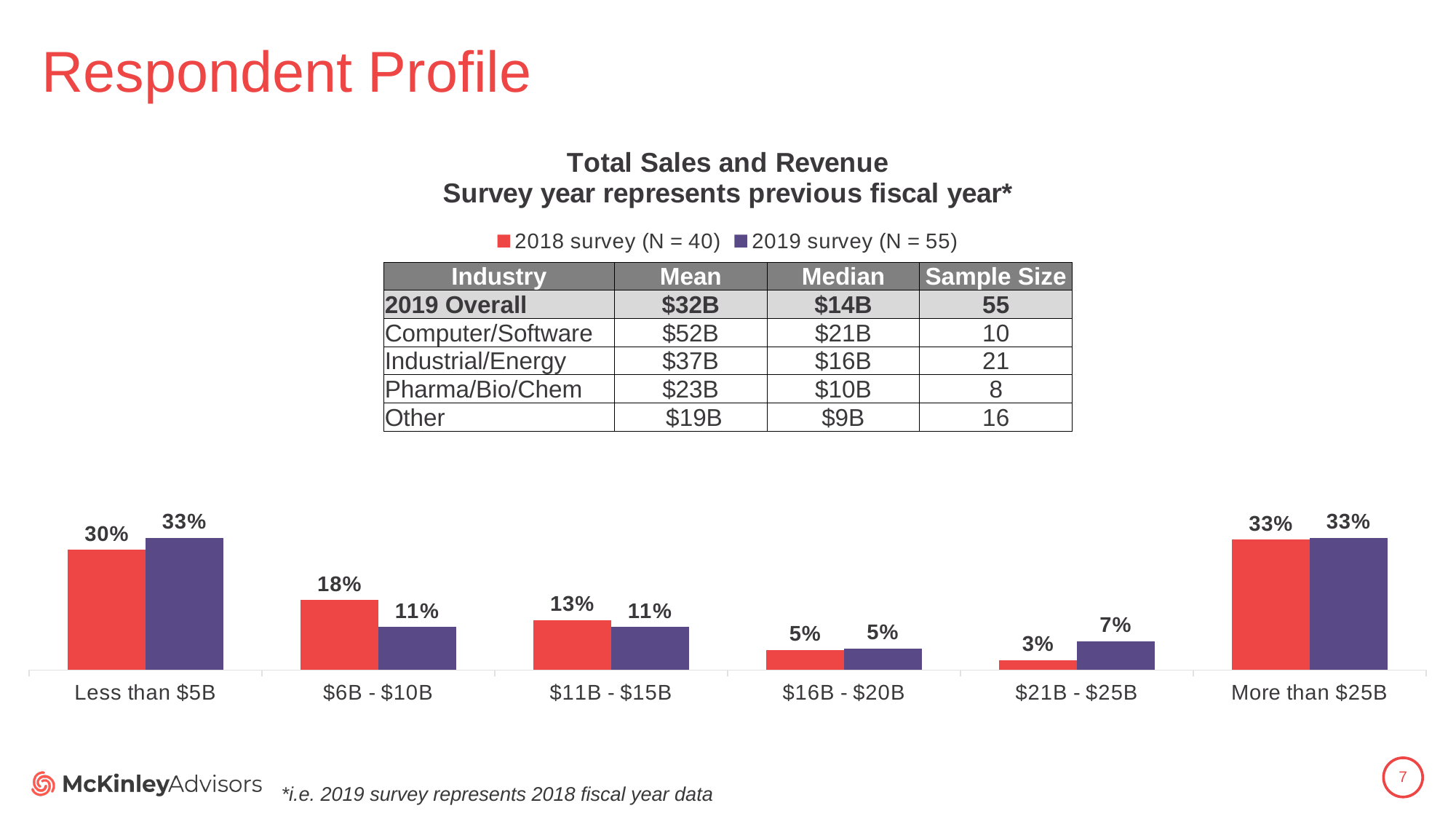
Which category has the lowest value for the 2018 survey? $21B - $25B What is the difference between the 2018 survey and 2019 survey values in the $6B - $10B category? 7 percentage points What is the value for the 2019 survey in the $21B - $25B category? 7% What type of chart is used to show the total sales and revenue distribution? Bar chart What percentage of 2019 survey respondents fall in the $6B - $10B category? 11% What is the sample size (N) for the 2019 survey according to the legend? 55 Which category has the highest value for the 2019 survey? Less than $5B and More than $25B (both 33%) How many sales and revenue categories are shown on the x axis of the chart? 6 In the $11B - $15B category, which survey has the larger value, 2018 or 2019? 2018 survey Which colour represents the 2018 survey in the chart? Red What percentage of 2018 survey respondents reported total sales and revenue of less than $5B? 30% How many series does the chart legend list? 2